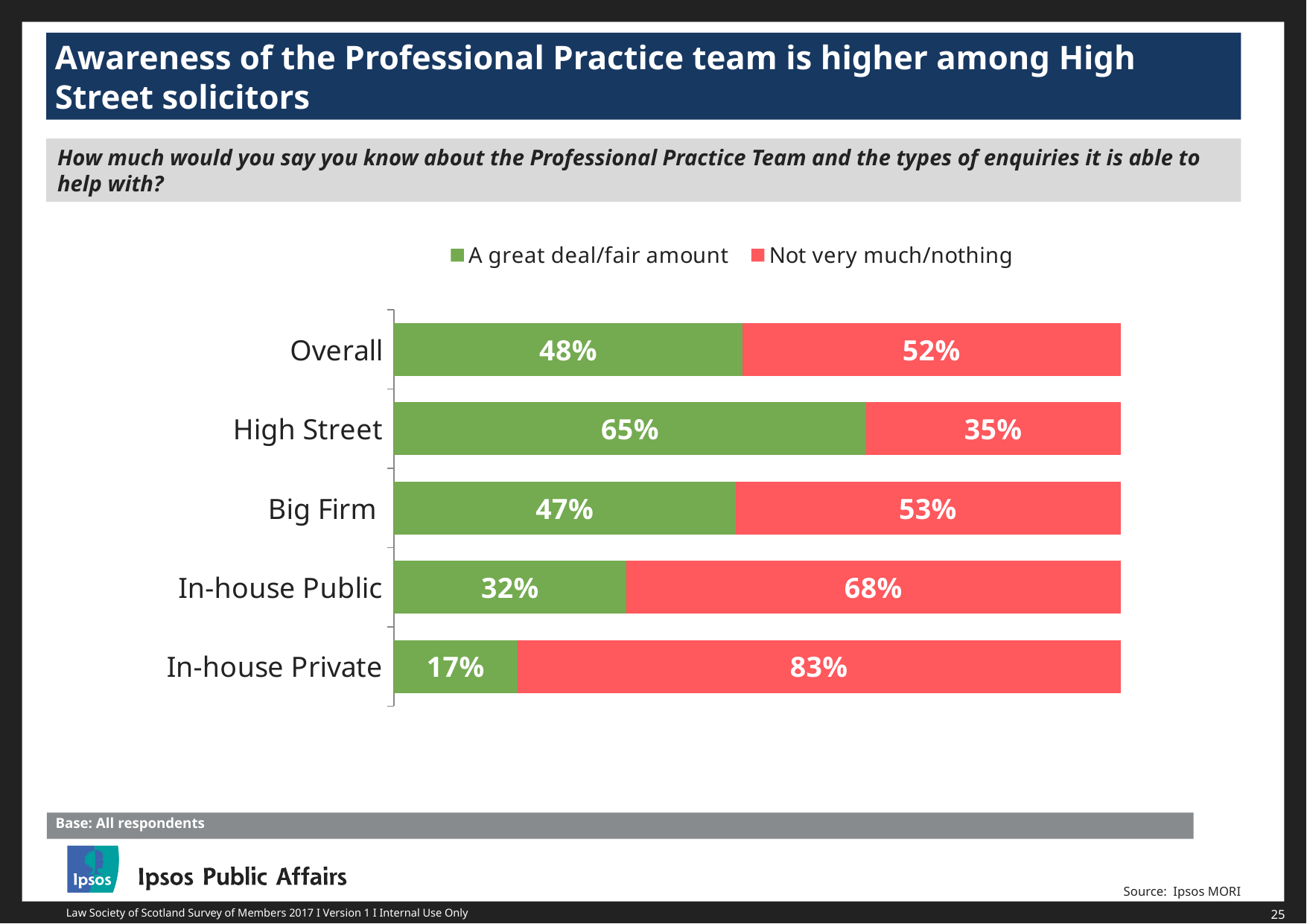
Which is larger: the 'A great deal/fair amount' value for Big Firm or for In-house Public? Big Firm What is the total of the stacked bar for Big Firm? 100% What percentage of High Street solicitors say they know a great deal/fair amount about the Professional Practice Team? 65% What is the difference between the 'Not very much/nothing' values for In-house Public and Big Firm? 15 percentage points What is the 'A great deal/fair amount' value for Overall? 48% How many categories are shown on the chart? 5 What kind of chart is shown on the slide? Stacked bar chart Which colour represents 'Not very much/nothing' in the chart? Red Which category has the lowest 'A great deal/fair amount' value? In-house Private What is the 'Not very much/nothing' value for In-house Private? 83% How many series does the legend list? 2 Which category has the highest 'A great deal/fair amount' value? High Street